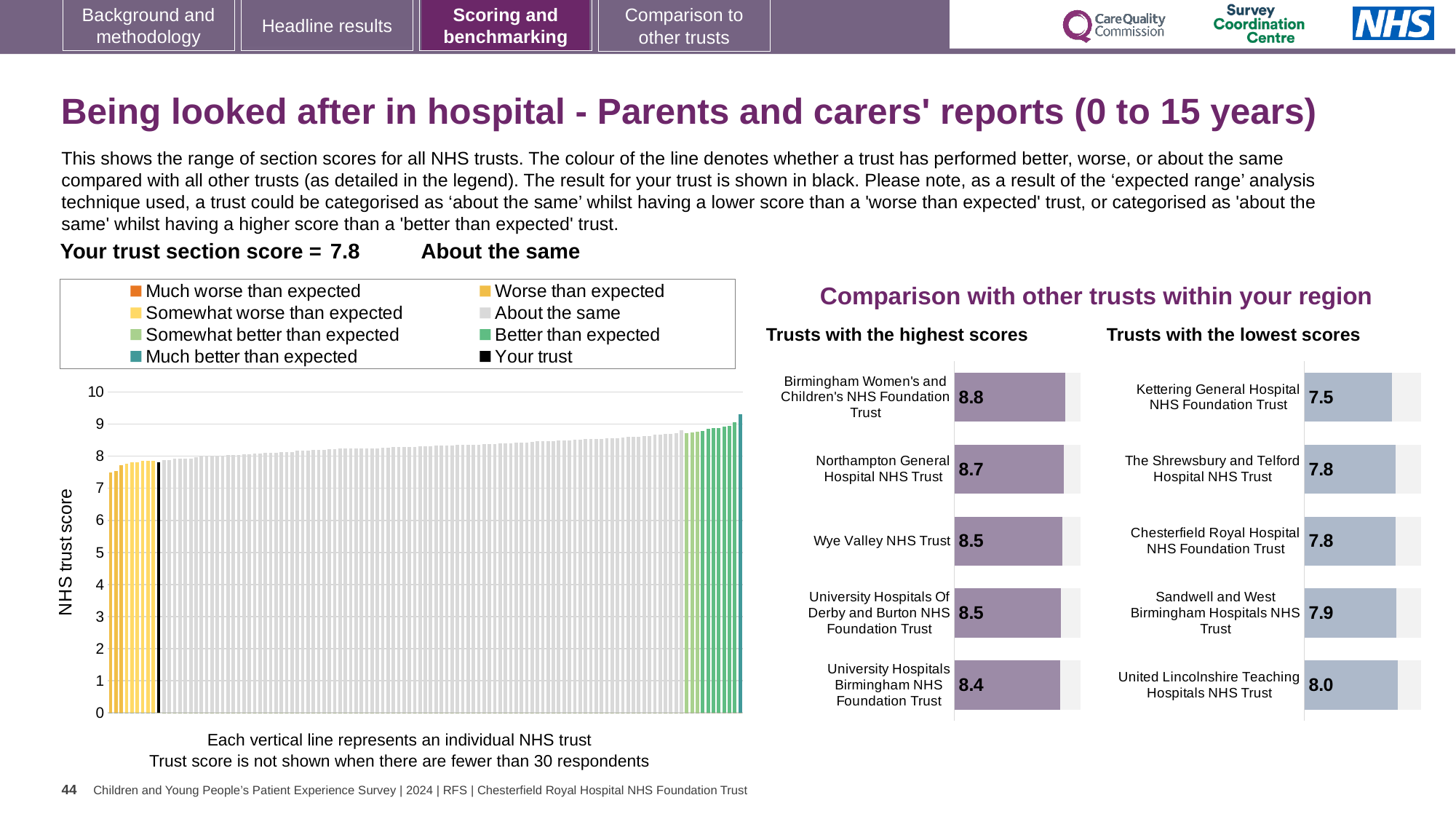
In the main 'NHS trust score' chart on the left, what is the section score for your trust? 7.8 In the 'Trusts with the lowest scores' chart, what is the score for United Lincolnshire Teaching Hospitals NHS Trust? 8.0 In the 'Trusts with the lowest scores' chart, which has the larger score: Sandwell and West Birmingham Hospitals NHS Trust or Kettering General Hospital NHS Foundation Trust? Sandwell and West Birmingham Hospitals NHS Trust In the 'Trusts with the lowest scores' chart, which trust has the lowest score? Kettering General Hospital NHS Foundation Trust In the 'Trusts with the highest scores' chart, which trust has the highest score? Birmingham Women's and Children's NHS Foundation Trust In the main 'NHS trust score' chart on the left, do the trust scores rise or fall from left to right? rise In the 'Trusts with the highest scores' chart, what is the score for Birmingham Women's and Children's NHS Foundation Trust? 8.8 In the 'Trusts with the highest scores' chart, what is the score for Wye Valley NHS Trust? 8.5 How many trusts are shown in the 'Trusts with the highest scores' chart? 5 In the 'Trusts with the highest scores' chart, what is the difference between the scores of Birmingham Women's and Children's NHS Foundation Trust and University Hospitals Birmingham NHS Foundation Trust? 0.4 In the 'Trusts with the lowest scores' chart, what is the score for Kettering General Hospital NHS Foundation Trust? 7.5 How many entries does the legend of the main 'NHS trust score' chart list? 8